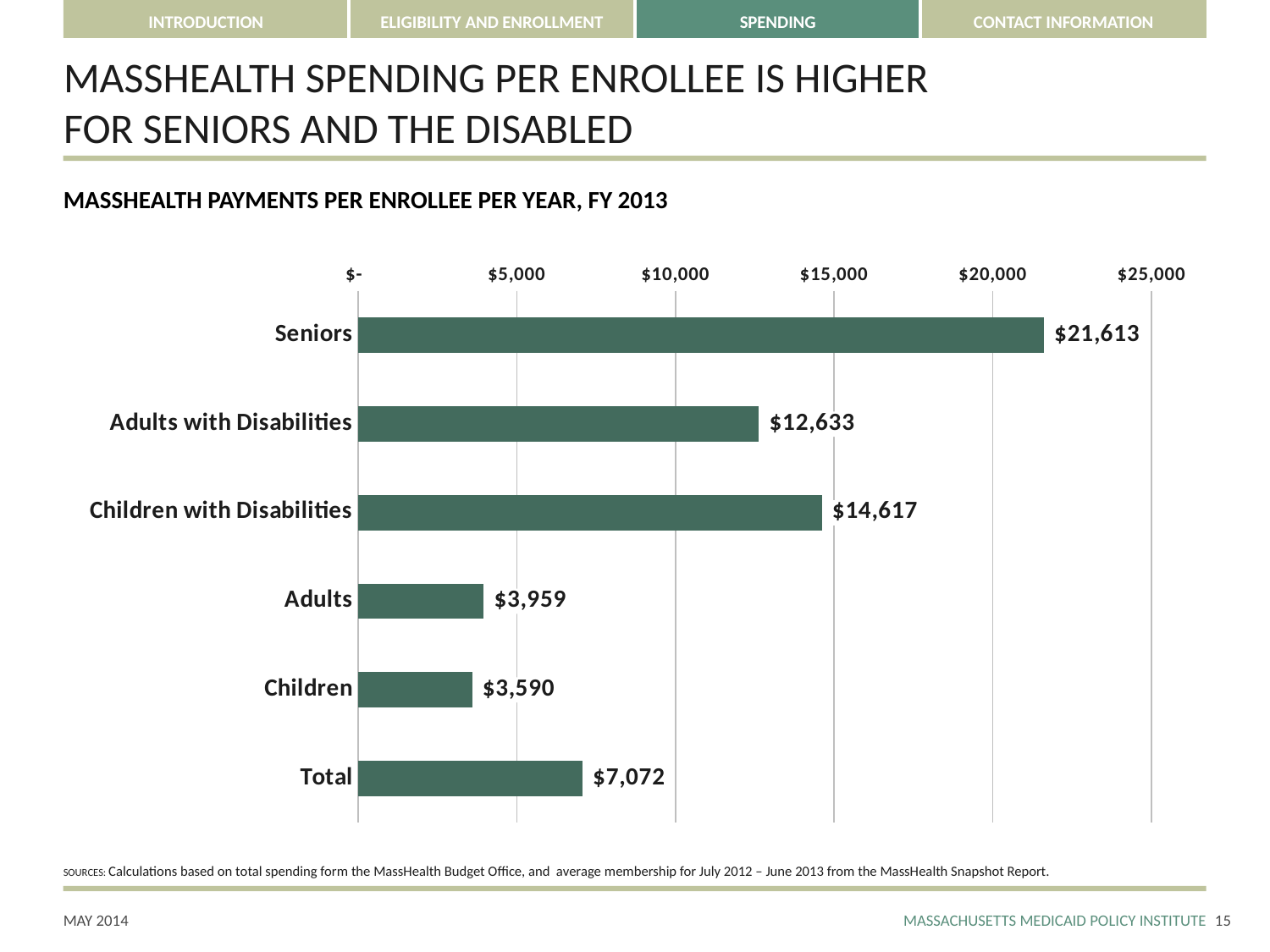
Which is larger, the payment per enrollee for Adults with Disabilities or for Children with Disabilities? Children with Disabilities What is the Total payment per enrollee per year? $7,072 Which category has the highest payment per enrollee? Seniors What is the difference between the payment per enrollee for Children with Disabilities and for Adults with Disabilities? $1,984 What is the payment per enrollee for Adults with Disabilities? $12,633 What is the MassHealth payment per enrollee per year for Seniors? $21,613 How many categories are shown in the chart? 6 What is the payment per enrollee for Children? $3,590 What type of chart is shown on the slide? Bar chart Which category has the lowest payment per enrollee? Children What is the difference between the payment per enrollee for Seniors and for Adults with Disabilities? $8,980 Is the payment per enrollee for Seniors greater or less than $20,000? greater